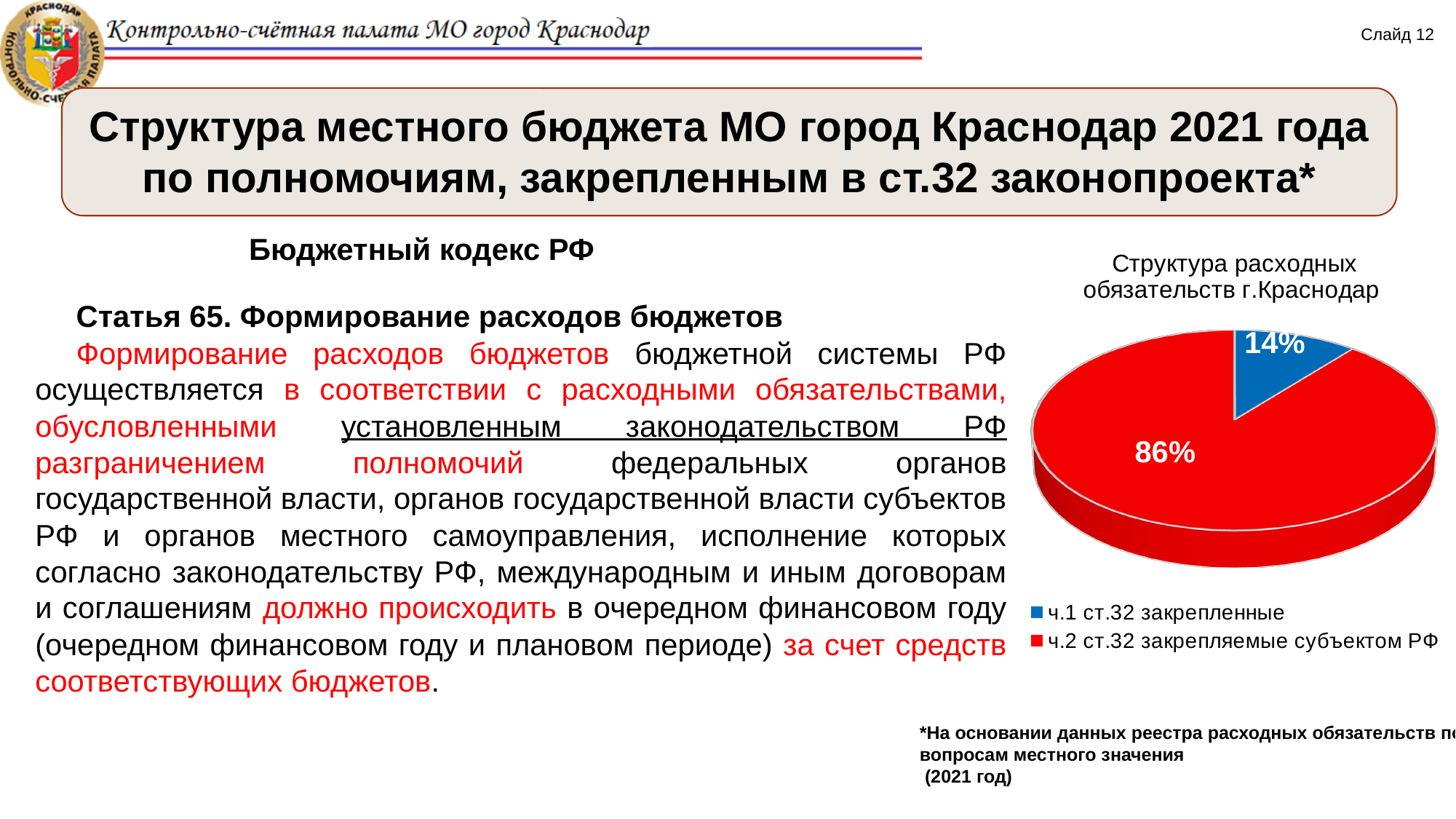
Which is larger: the share for "ч.1 ст.32 закрепленные" or the share for "ч.2 ст.32 закрепляемые субъектом РФ"? ч.2 ст.32 закрепляемые субъектом РФ What is the title of the chart? Структура расходных обязательств г.Краснодар Which slice of the pie is the largest? ч.2 ст.32 закрепляемые субъектом РФ How many entries does the chart legend list? 2 What is the difference in percentage points between the "ч.2 ст.32 закрепляемые субъектом РФ" slice and the "ч.1 ст.32 закрепленные" slice? 72 Which slice of the pie is the smallest? ч.1 ст.32 закрепленные What kind of chart is shown on the slide? pie chart What share of the pie does "ч.1 ст.32 закрепленные" take? 14% How many slices does the pie chart have? 2 What share of the pie does "ч.2 ст.32 закрепляемые субъектом РФ" take? 86% What colour is the slice for "ч.1 ст.32 закрепленные"? blue